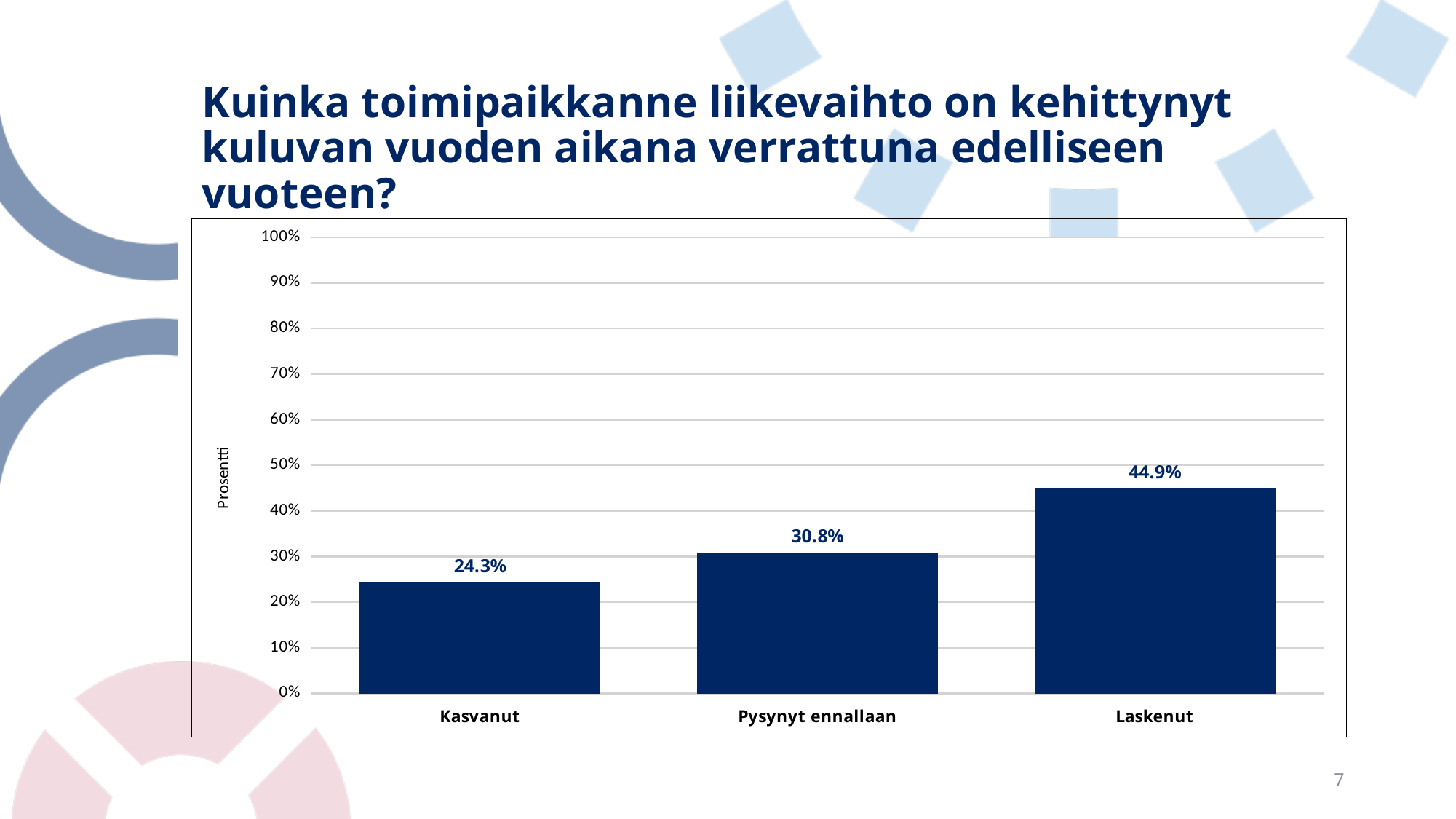
Which category has the highest value? Laskenut What kind of chart is shown on the slide? bar chart What is the label of the vertical axis? Prosentti What is the value for Kasvanut? 24.3% How many categories are shown on the x axis? 3 What is the value for Laskenut? 44.9% What is the difference between the values for Laskenut and Kasvanut? 20.6% What is the difference between the values for Pysynyt ennallaan and Kasvanut? 6.5% Which category has the lowest value? Kasvanut Which is larger, the value for Pysynyt ennallaan or the value for Laskenut? Laskenut Is the value for Laskenut greater or less than 40%? greater What is the value for Pysynyt ennallaan? 30.8%